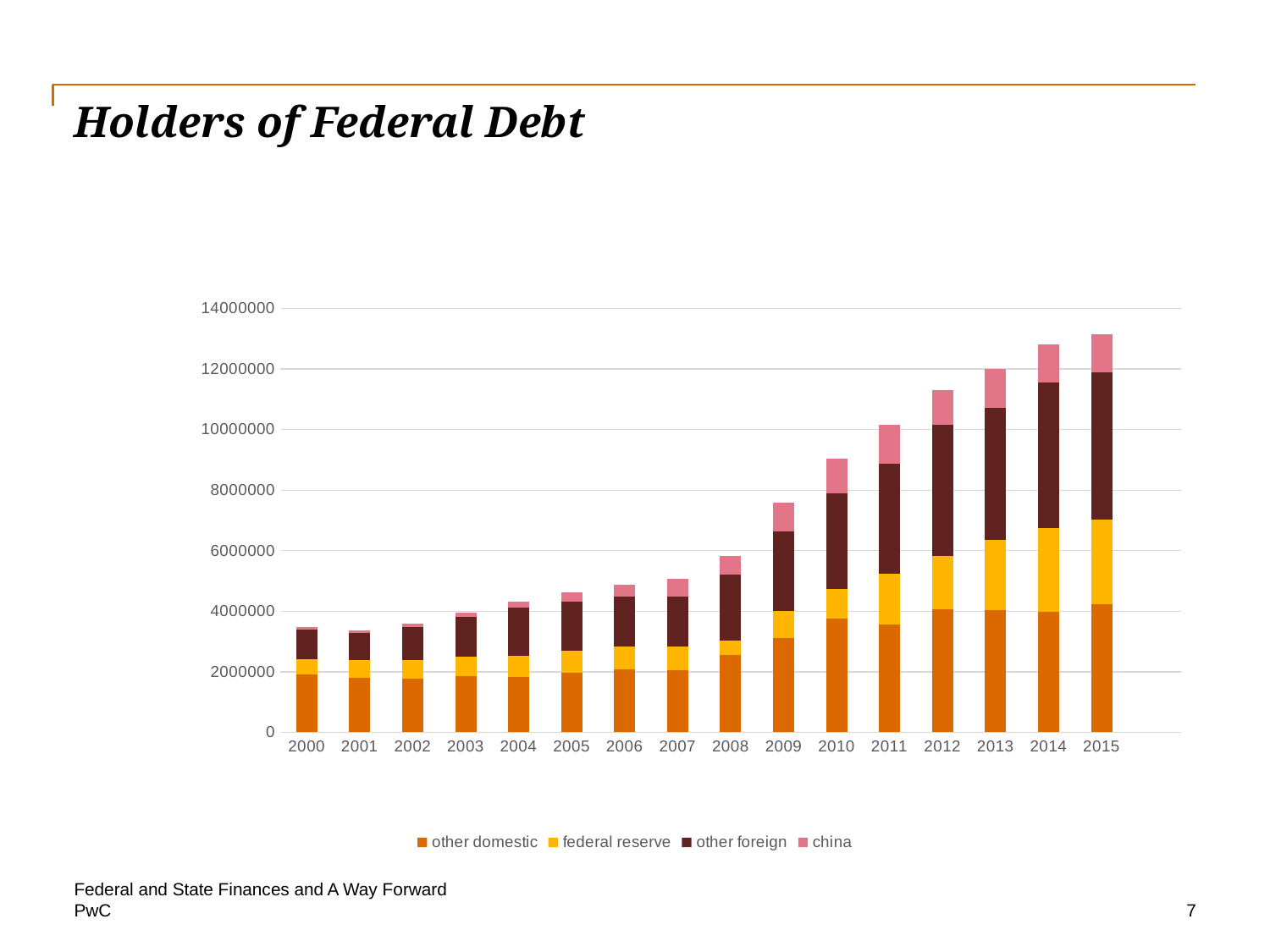
Which year has the larger total, 2008 or 2009? 2009 Is the total for 2000 greater or less than 4000000? less Which year has the highest total stacked bar? 2015 What kind of chart is shown on the slide? stacked bar chart How many series does the legend list? 4 How many years are shown on the x axis? 16 Do the total bar heights generally rise or fall from 2000 to 2015? rise Is the total for 2015 greater or less than 12000000? greater Which series are listed in the legend? other domestic, federal reserve, other foreign, china What is the title of the chart? Holders of Federal Debt Is the total for 2012 greater or less than 10000000? greater